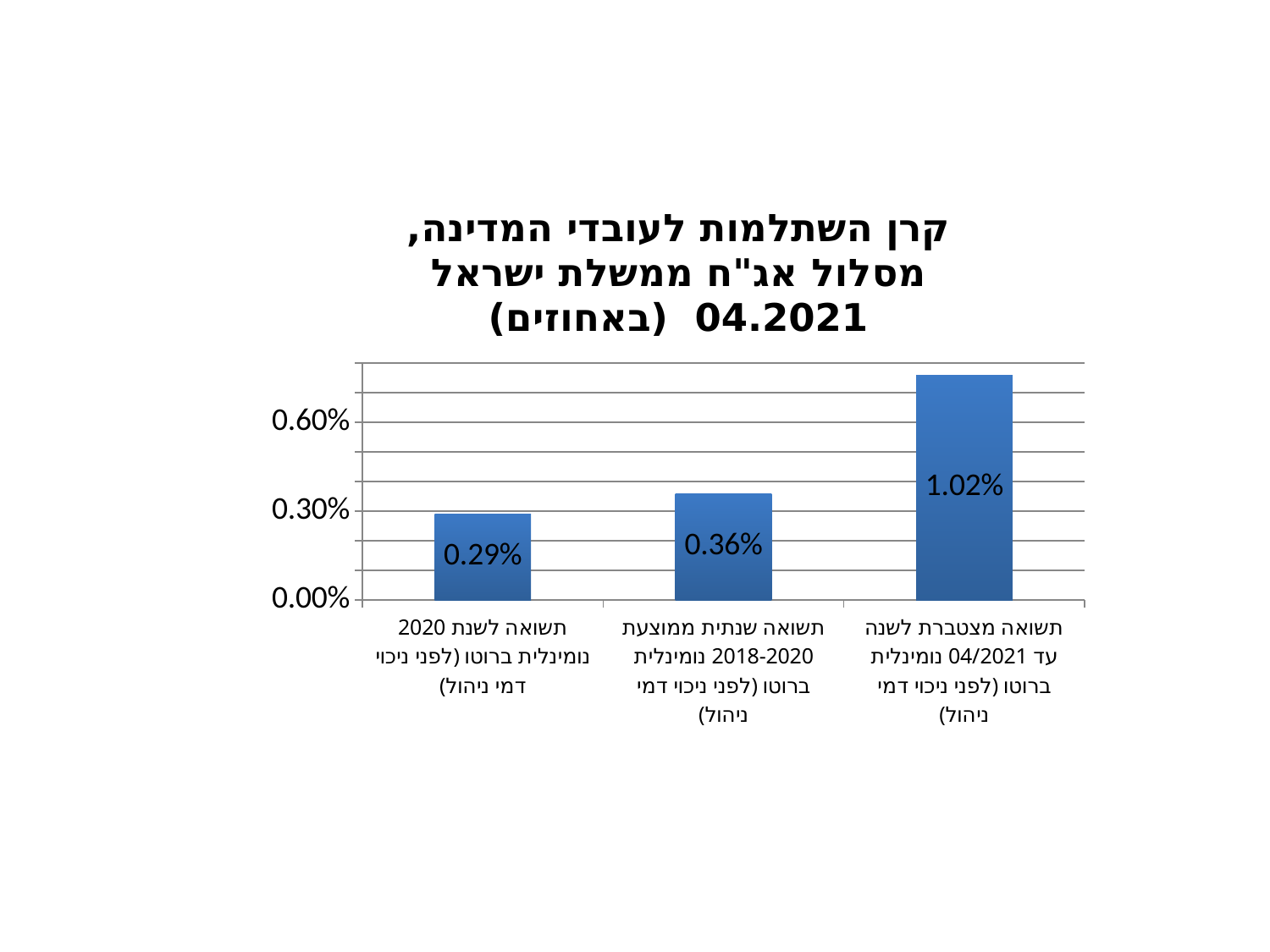
What is the title of the chart? קרן השתלמות לעובדי המדינה, מסלול אג"ח ממשלת ישראל 04.2021 (באחוזים) How many bars are shown in the chart? 3 What type of chart is shown on the slide? Bar chart What is the difference between the cumulative return to 04/2021 (1.02%) and the 2020 return (0.29%)? 0.73% Which category has the highest value? תשואה מצטברת לשנה עד 04/2021 נומינלית ברוטו (לפני ניכוי דמי ניהול) What is the difference between the average annual return 2018-2020 and the 2020 return? 0.07% What is the value shown for the 2020 return (תשואה לשנת 2020)? 0.29% Is the value for the 2020 return greater or less than 0.30%? less What is the value shown for the average annual return 2018-2020 (תשואה שנתית ממוצעת 2018-2020)? 0.36% Which category has the lowest value? תשואה לשנת 2020 נומינלית ברוטו (לפני ניכוי דמי ניהול) What is the value shown for the cumulative return for the year to 04/2021 (תשואה מצטברת לשנה עד 04/2021)? 1.02% Which is larger: the average annual return 2018-2020 or the 2020 return? The average annual return 2018-2020 (0.36%)